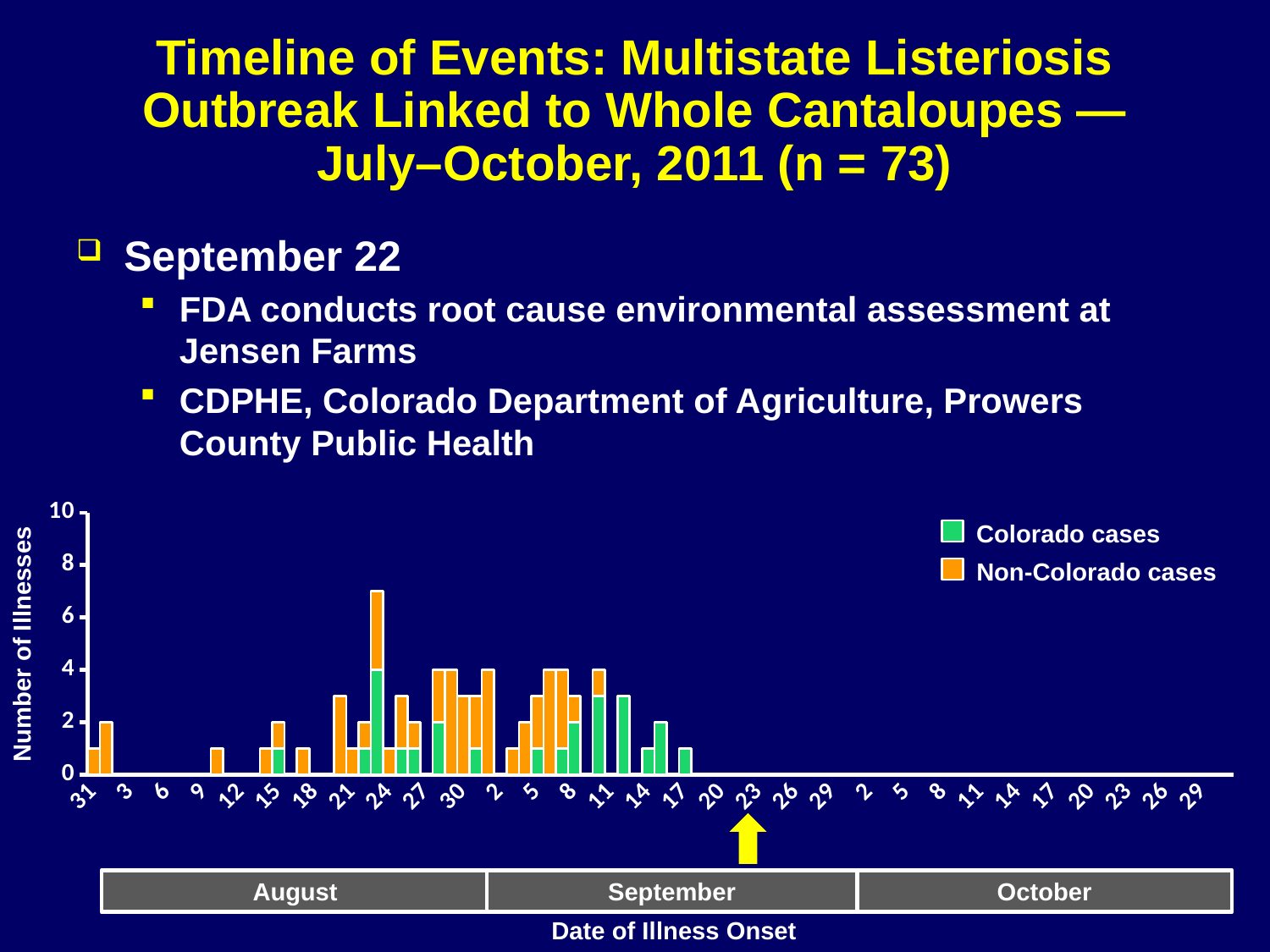
What are the two series named in the chart legend? Colorado cases and Non-Colorado cases Is the number of illnesses for August 24 greater or less than 8? less Do the numbers of illnesses rise or fall from mid-September into October? fall What kind of chart is shown on the slide? bar chart What is the title of the chart's vertical axis? Number of Illnesses How many series does the chart legend list? 2 Which has more illnesses, August 24 or September 11? August 24 How many months are labelled along the x axis of the chart? 3 Is the number of illnesses for September 17 greater or less than 2? less